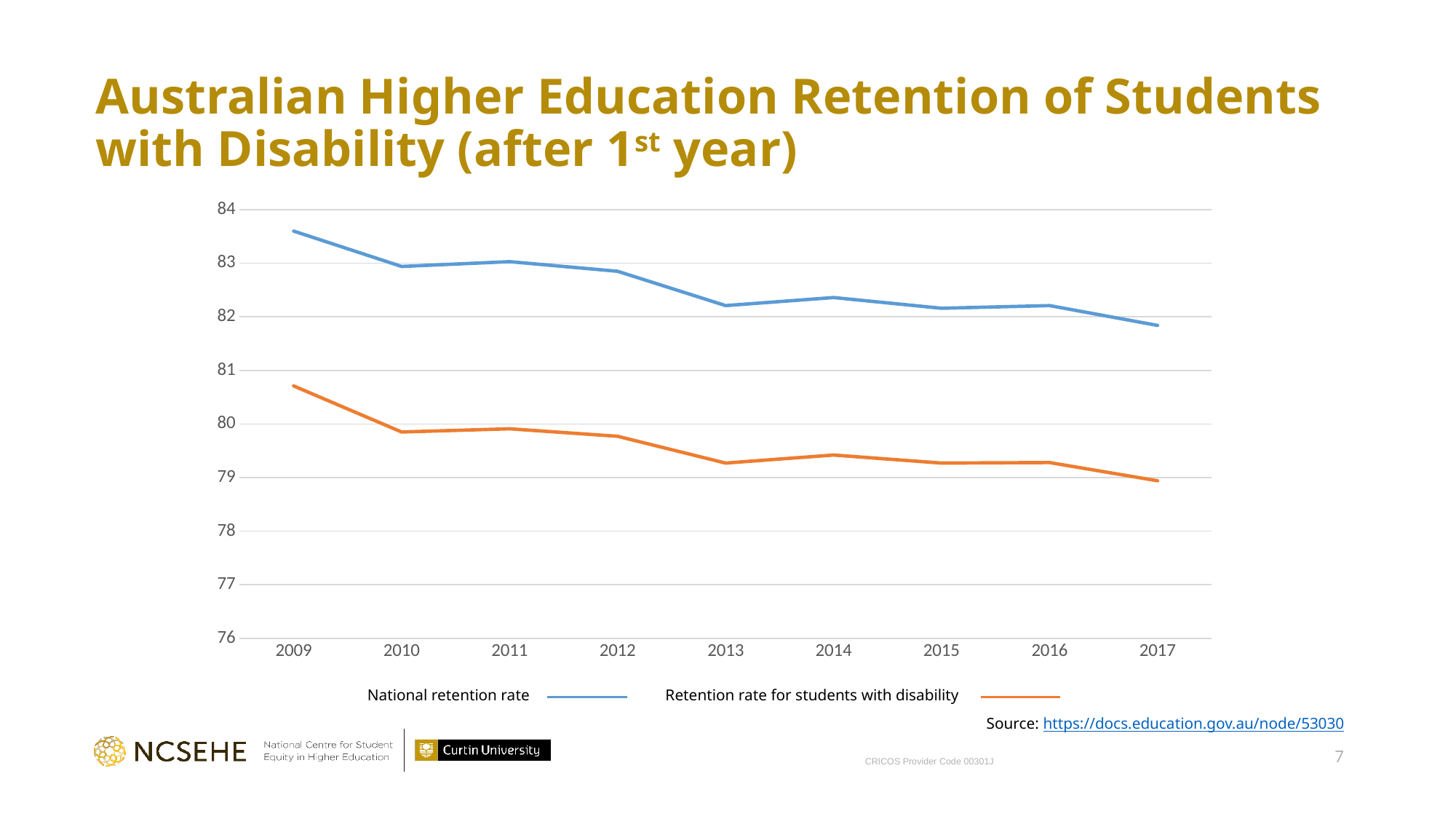
In which year is the Retention rate for students with disability highest? 2009 In which year is the National retention rate lowest? 2017 What is the first year shown on the x axis? 2009 In 2014, which is larger: the National retention rate or the Retention rate for students with disability? National retention rate Overall, does the National retention rate rise or fall from 2009 to 2017? Fall How many series does the legend list? 2 Is the National retention rate in 2009 greater or less than 83? greater Is the Retention rate for students with disability in 2010 greater or less than 80? less How many years are plotted along the x axis? 9 Which series is drawn in orange? Retention rate for students with disability What kind of chart is shown on the slide? Line chart Is the National retention rate in 2017 greater or less than 82? less